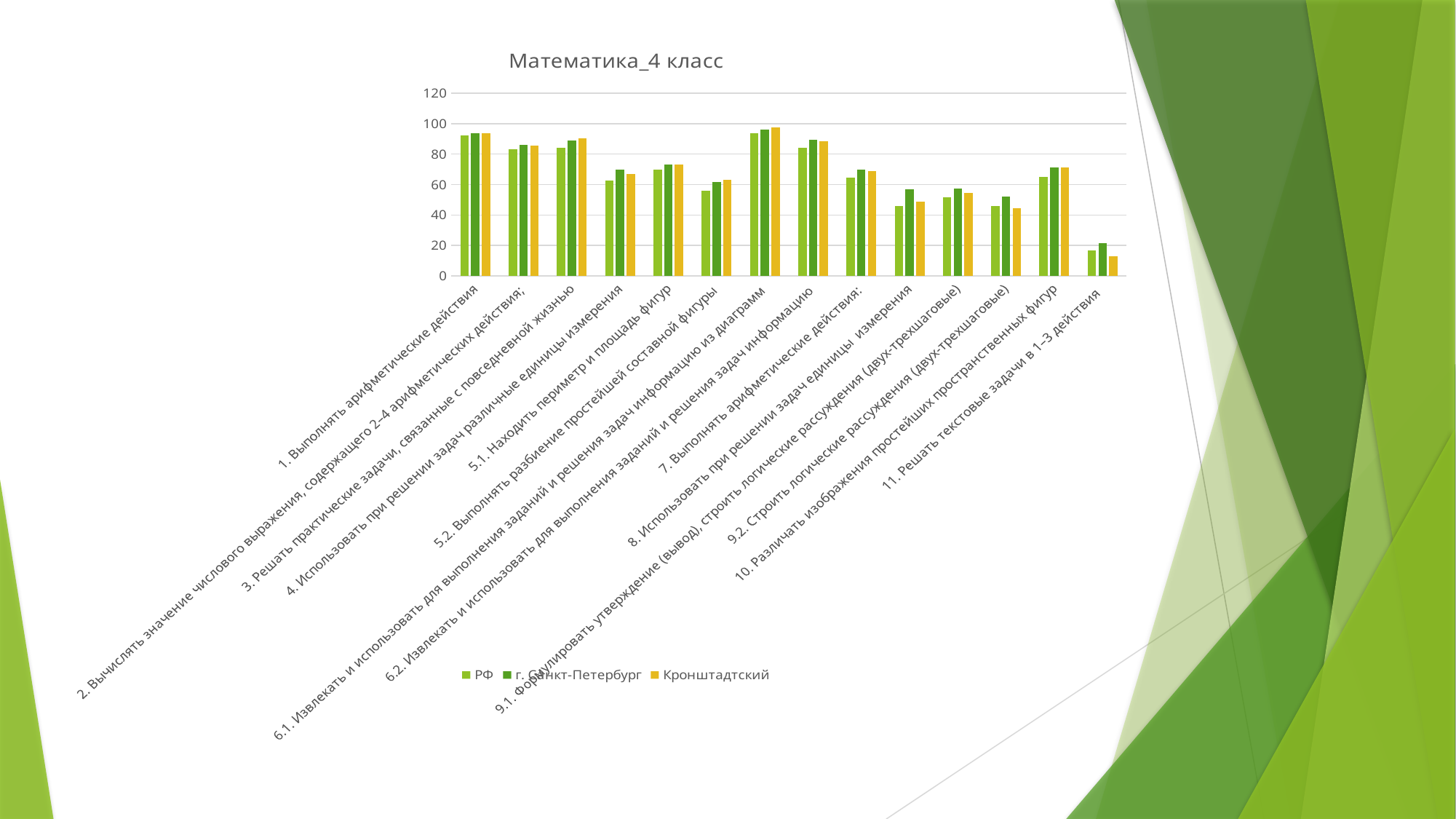
Which category has the lowest value for the РФ series? 11. Решать текстовые задачи в 1–3 действия How many series does the legend list? 3 What kind of chart is shown on the slide? bar chart Is the value for РФ in category '11. Решать текстовые задачи в 1–3 действия' greater or less than 20? less In category '8. Использовать при решении задач единицы измерения', which is larger: РФ or г. Санкт-Петербург? г. Санкт-Петербург How many categories are shown on the x axis? 14 Is the value for Кронштадтский in category '6.1. Извлекать и использовать для выполнения заданий и решения задач информацию из диаграмм' greater or less than 80? greater Which category has the lowest value for the Кронштадтский series? 11. Решать текстовые задачи в 1–3 действия Which series are listed in the legend? РФ, г. Санкт-Петербург, Кронштадтский What is the title of the chart? Математика_4 класс Is the value for РФ in category '8. Использовать при решении задач единицы измерения' greater or less than 60? less In category '11. Решать текстовые задачи в 1–3 действия', which is larger: г. Санкт-Петербург or Кронштадтский? г. Санкт-Петербург